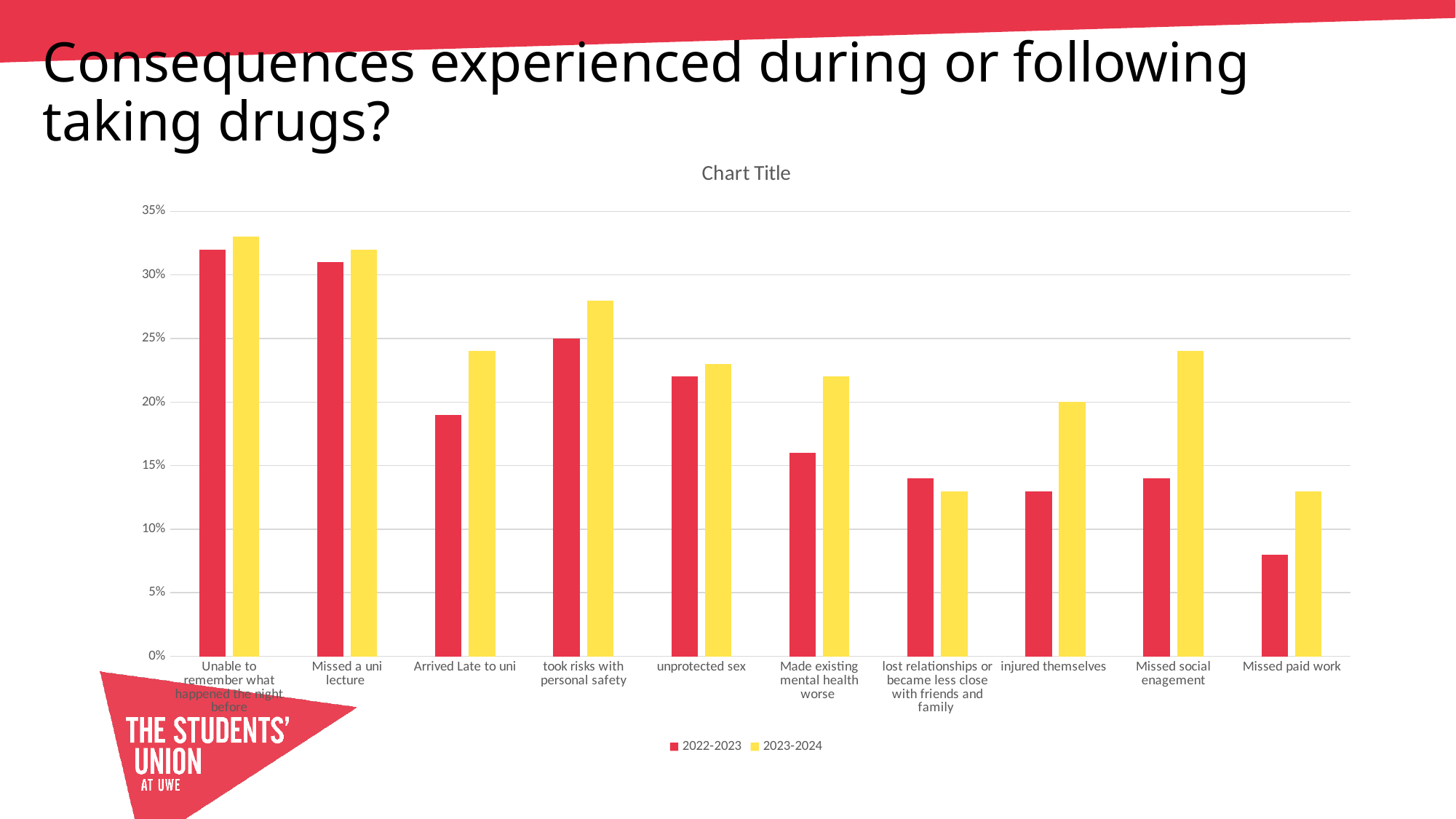
Is the 2022-2023 value for 'Missed paid work' greater or less than 10%? less What kind of chart is shown on the slide? Bar chart What colour are the bars for the 2023-2024 series? Yellow Which category has the lowest value for the 2022-2023 series? Missed paid work For 'Missed social enagement', which series has the larger value, 2022-2023 or 2023-2024? 2023-2024 How many series does the chart's legend list? 2 How many categories are shown along the x axis of the chart? 10 Is the 2022-2023 value for 'Made existing mental health worse' greater or less than 20%? less Is the 2023-2024 value for 'Missed social enagement' greater or less than 20%? greater Which category has the highest value for the 2023-2024 series? Unable to remember what happened the night before For 'injured themselves', which series has the larger value, 2022-2023 or 2023-2024? 2023-2024